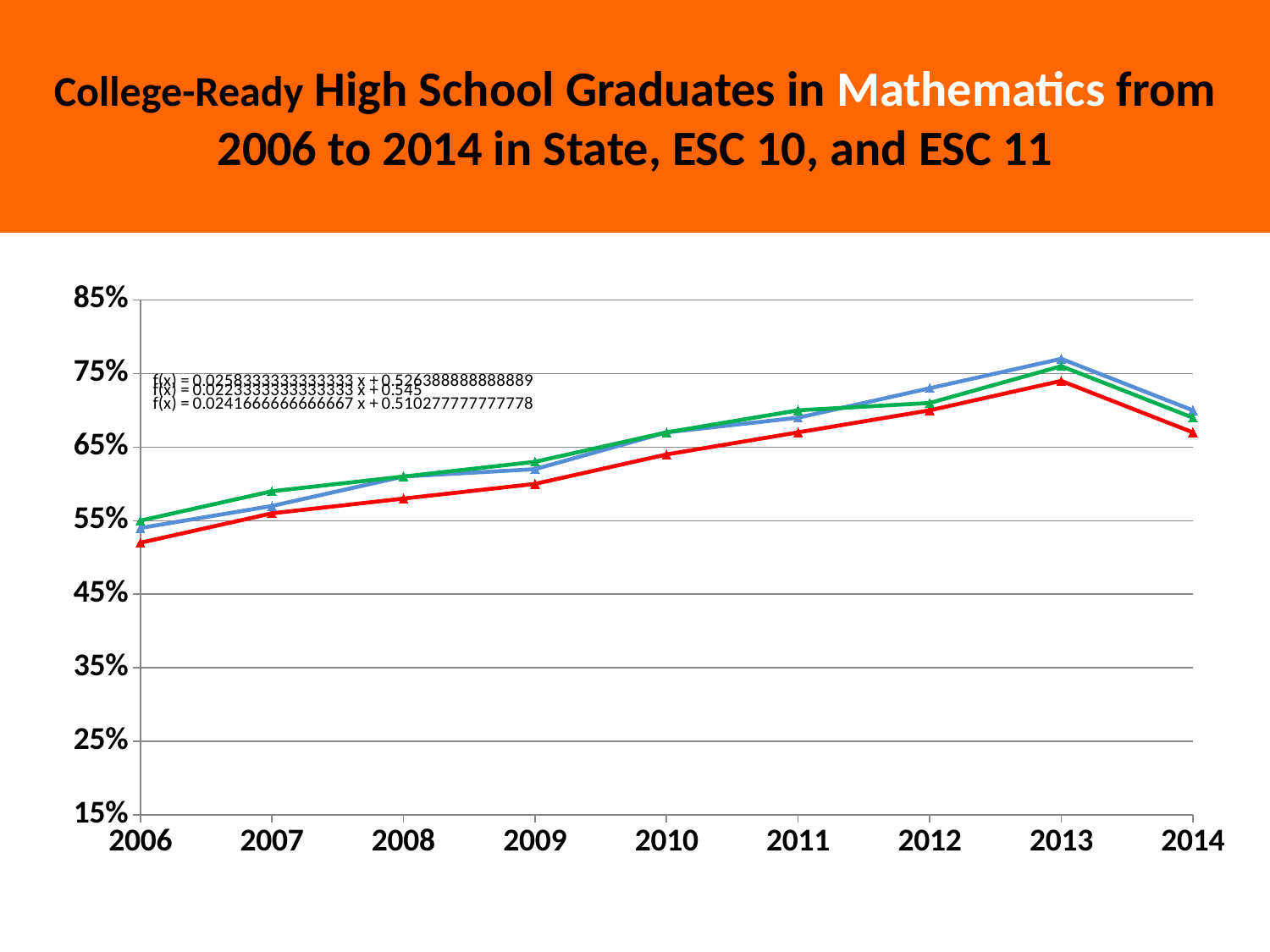
What kind of chart is shown on the slide? line chart In which year does the red line reach its highest value? 2013 Is the value of the red line in 2009 greater or less than 65%? less Is the value of the red line in 2006 greater or less than 55%? less How many lines are plotted on the chart? 3 In which year does the blue line reach its lowest value? 2006 How many years are shown along the x axis of the chart? 9 Do the lines generally rise or fall from 2006 to 2013? rise What is the last year shown on the x axis? 2014 In 2014, which line has the higher value, the blue line or the red line? blue line Is the value of the blue line in 2013 greater or less than 75%? greater What is the first year shown on the x axis? 2006